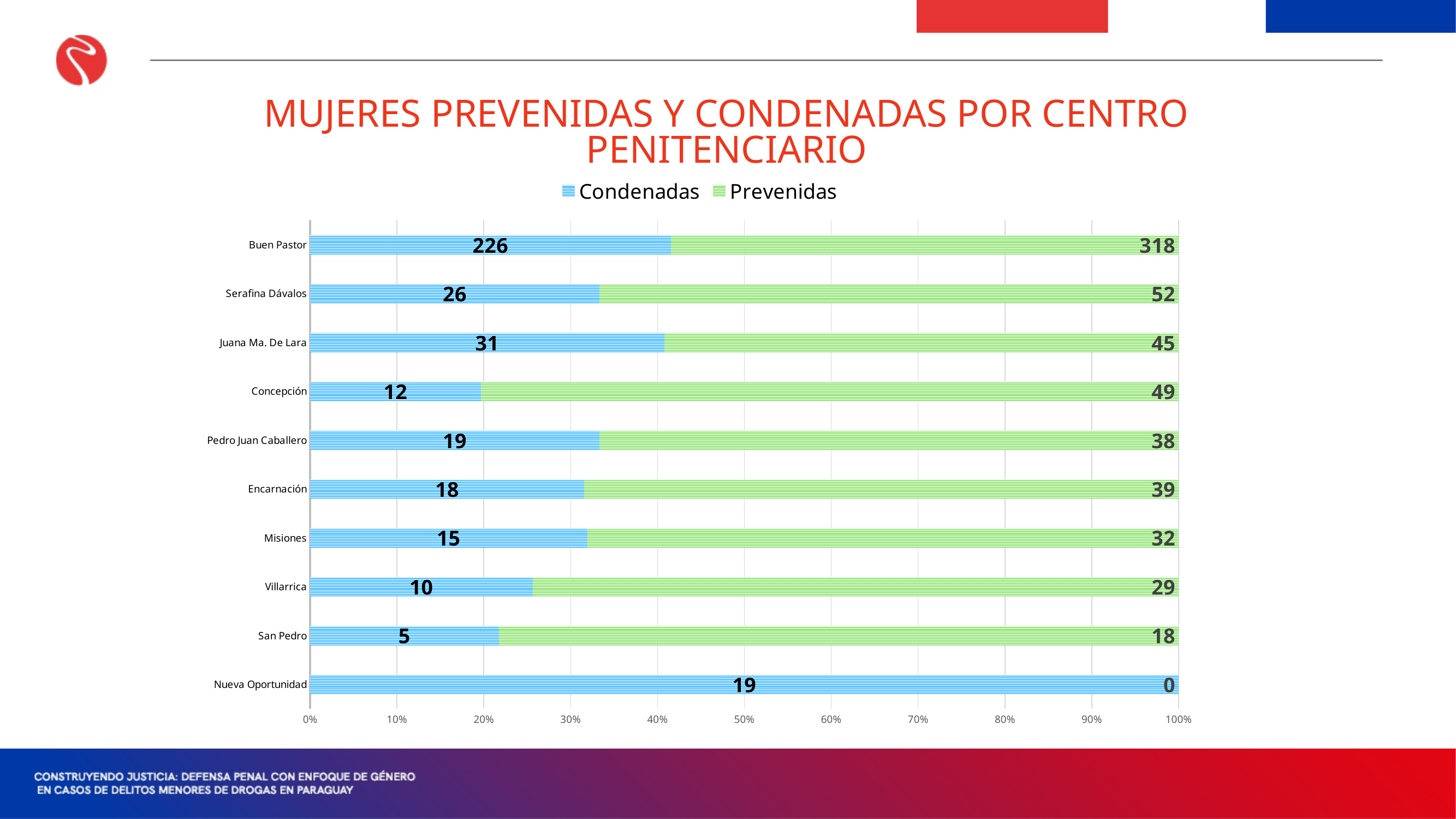
How many series does the legend list? 2 Which is larger for Serafina Dávalos, Condenadas or Prevenidas? Prevenidas Which centre has the lowest Condenadas value? San Pedro How many centres are shown on the chart? 10 What is the Prevenidas value for Nueva Oportunidad? 0 What is the difference between the Prevenidas and Condenadas values for Buen Pastor? 92 What is the total of Condenadas and Prevenidas for Buen Pastor? 544 Which centre has the highest Condenadas value? Buen Pastor Is the Condenadas share of the bar for Concepción greater or less than 30%? less What is the Prevenidas value for Concepción? 49 What is the Condenadas value for Buen Pastor? 226 What kind of chart is shown? Stacked bar chart